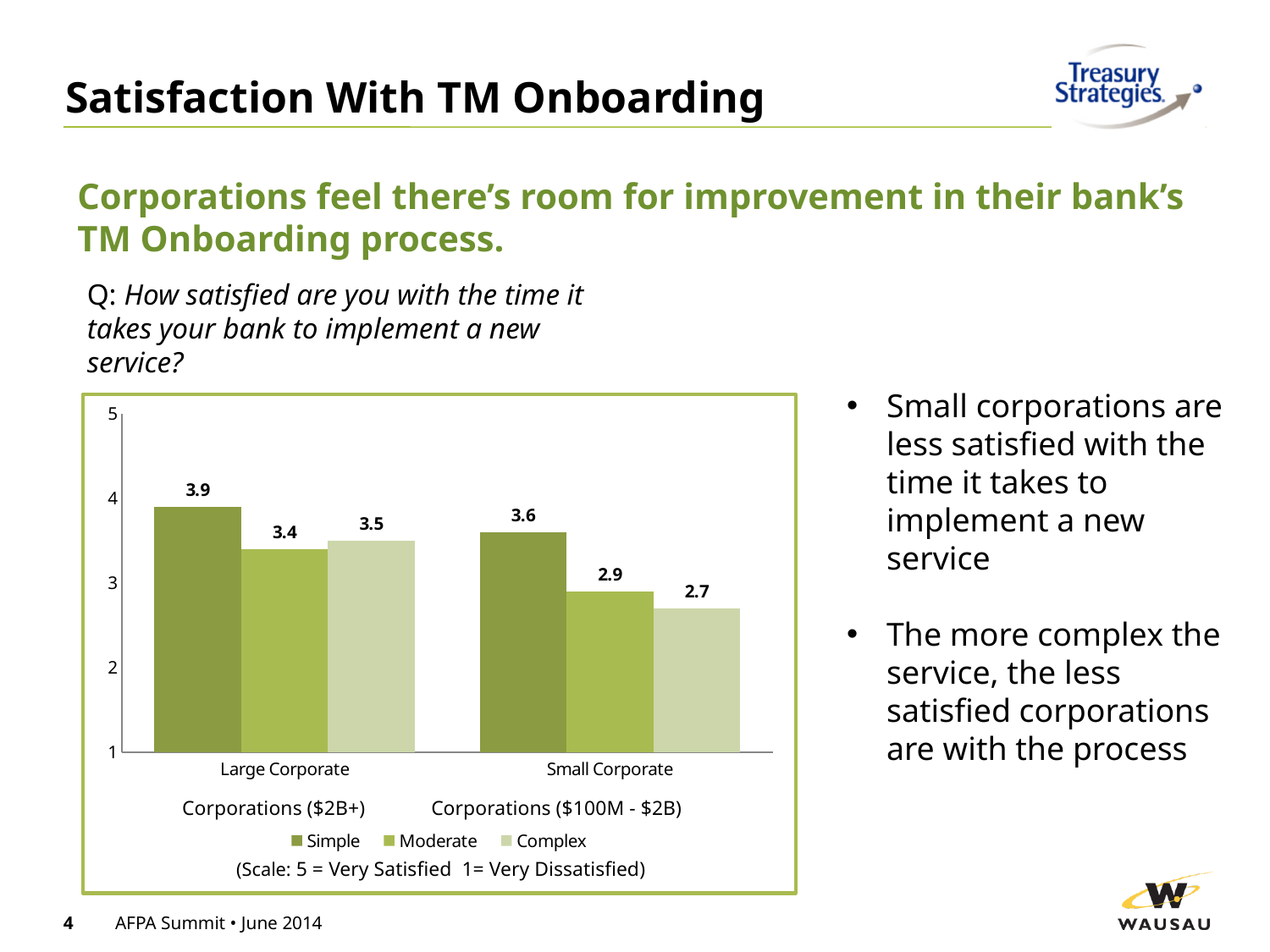
What kind of chart is shown? bar chart Which series has the highest score for Large Corporate? Simple Which series has the lowest score for Small Corporate? Complex How many series does the legend list? 3 Is the Complex score for Small Corporate greater or less than 3? less What are the three series listed in the legend? Simple, Moderate, Complex How many categories are shown on the x axis? 2 What is the Moderate satisfaction score for Small Corporate? 2.9 What is the difference between the Simple scores for Large Corporate and Small Corporate? 0.3 Which is larger: the Moderate score for Large Corporate or the Complex score for Large Corporate? Complex score for Large Corporate What is the Simple satisfaction score for Large Corporate? 3.9 What is the Complex satisfaction score for Small Corporate? 2.7